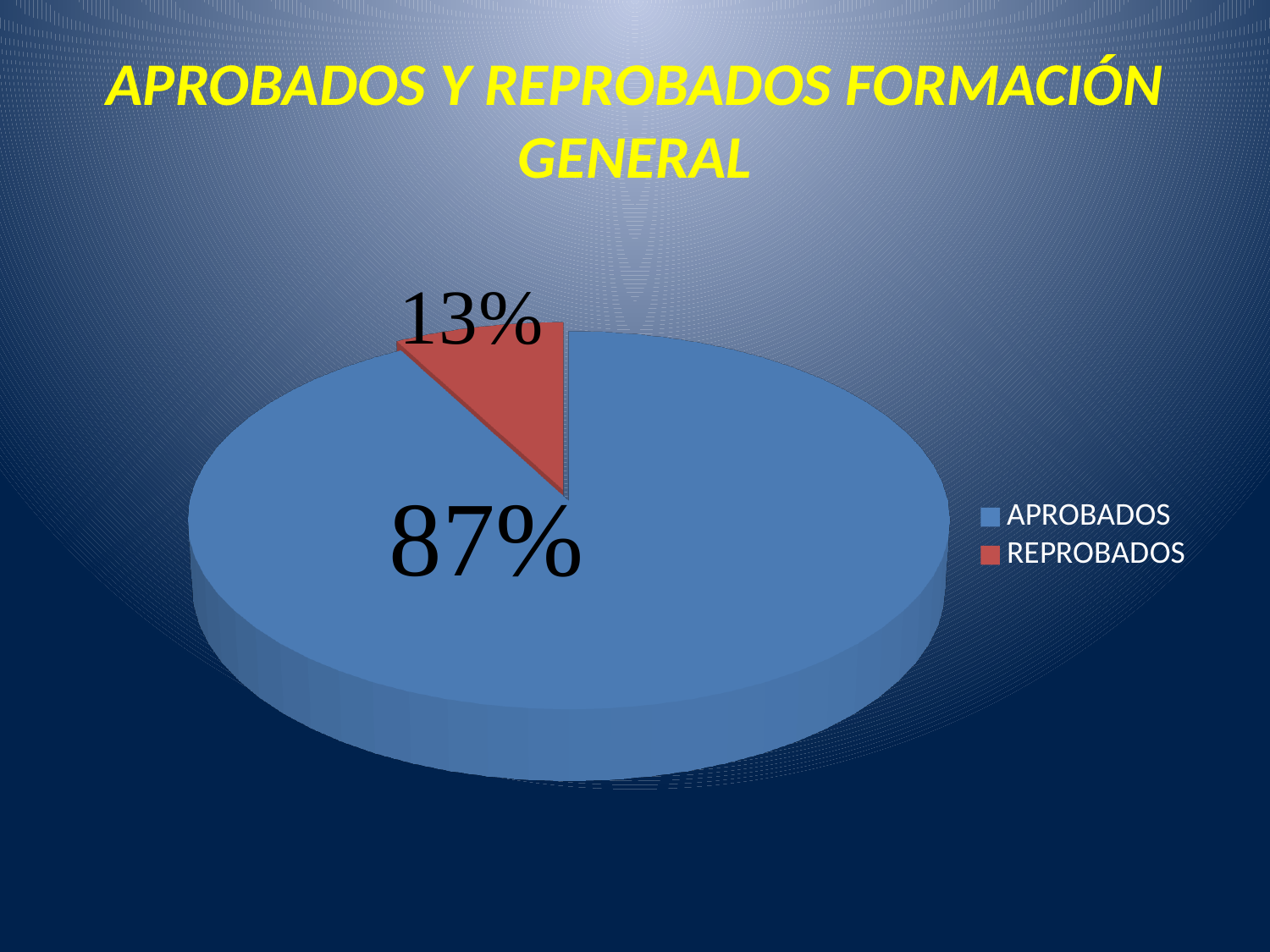
How many entries does the legend list? 2 What colour is the REPROBADOS slice? Red Which is larger, the share for APROBADOS or the share for REPROBADOS? APROBADOS What kind of chart is shown on the slide? Pie chart What is the difference in percentage points between APROBADOS and REPROBADOS? 74 How many slices does the pie chart have? 2 Which category has the smallest share of the pie? REPROBADOS What percentage of the pie is REPROBADOS? 13% What percentage of the pie is APROBADOS? 87% What is the title of the chart? APROBADOS Y REPROBADOS FORMACIÓN GENERAL Which category has the largest share of the pie? APROBADOS